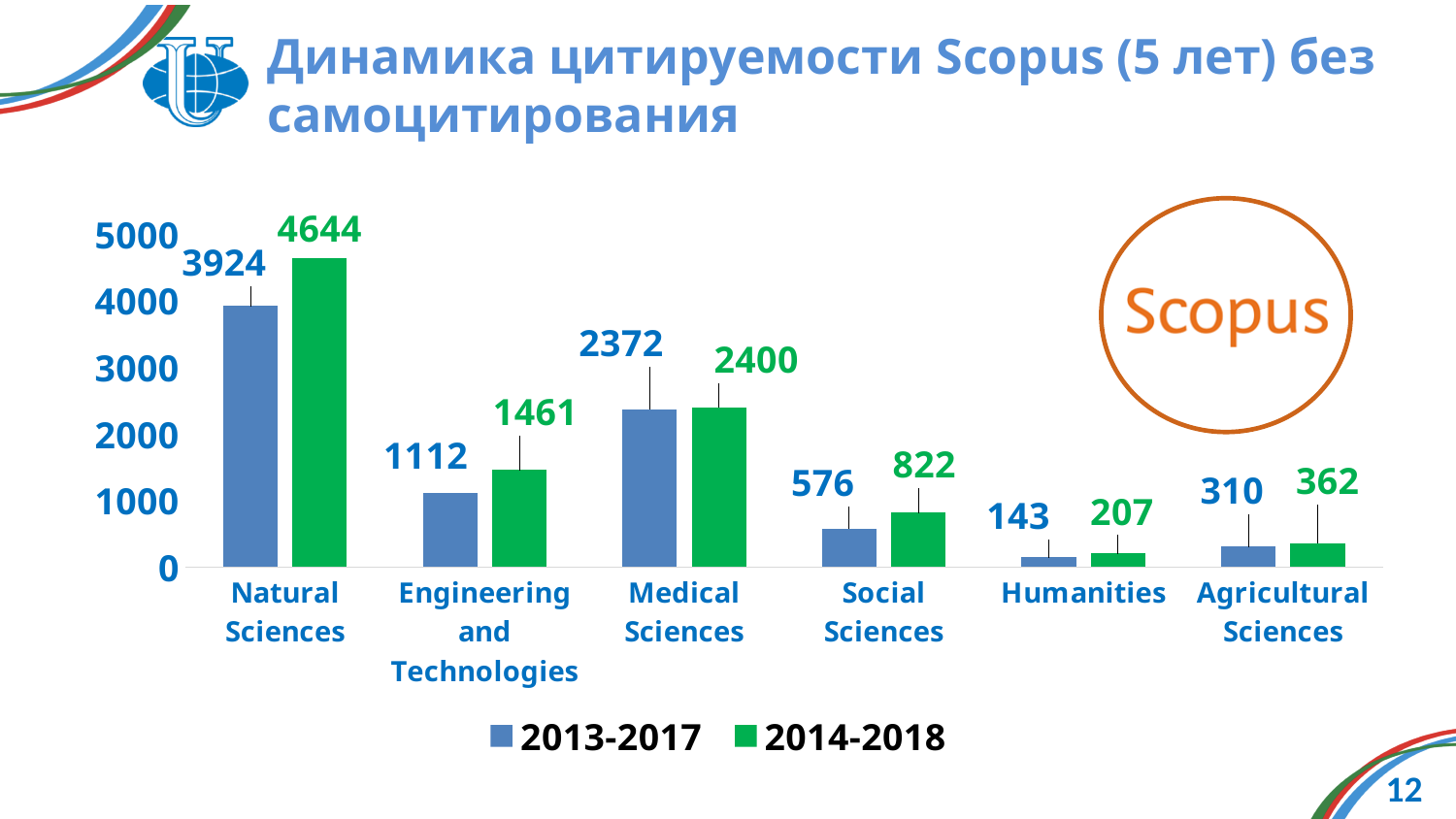
What is the value for Humanities in the 2014-2018 series? 207 What is the value for Natural Sciences in the 2014-2018 series? 4644 How many series does the legend list? 2 What is the difference between the 2014-2018 and 2013-2017 values for Natural Sciences? 720 Which is larger for Engineering and Technologies: the 2013-2017 value or the 2014-2018 value? 2014-2018 What kind of chart is shown on the slide? Bar chart How many categories are shown on the x axis? 6 What is the difference between the 2014-2018 and 2013-2017 values for Social Sciences? 246 Which colour represents the 2014-2018 series? Green What is the value for Engineering and Technologies in the 2013-2017 series? 1112 Which category has the lowest value in the 2014-2018 series? Humanities Which category has the highest value in the 2013-2017 series? Natural Sciences